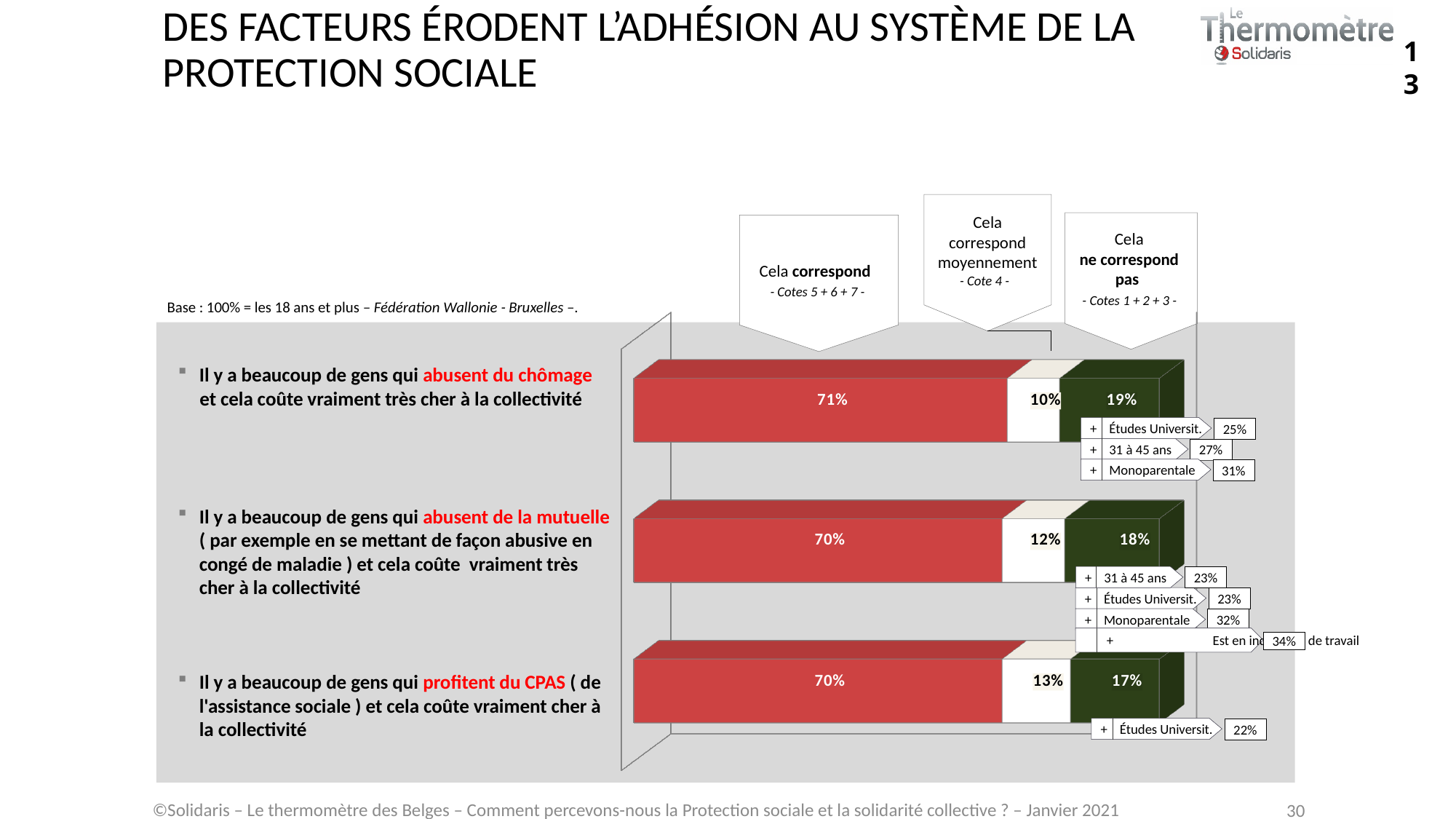
What percentage of respondents say 'Cela correspond moyennement' for the statement about people who 'profitent du CPAS'? 13% How many response categories (series) does each bar contain? 3 Which statement has the lowest 'Cela ne correspond pas' percentage? Il y a beaucoup de gens qui profitent du CPAS What is the total of the three segments for the 'abusent du chômage' bar? 100% Which rating scores (cotes) make up the 'Cela ne correspond pas' category according to the legend? Cotes 1 + 2 + 3 Which statement has the highest 'Cela correspond' percentage? Il y a beaucoup de gens qui abusent du chômage What is the difference between the 'Cela ne correspond pas' percentages for the 'abusent du chômage' statement and the 'profitent du CPAS' statement? 2% What percentage of respondents say 'Cela correspond' for the statement about people who 'abusent du chômage'? 71% What kind of chart is shown on the slide? bar chart Is the 'Cela correspond moyennement' value larger for the 'abusent de la mutuelle' statement or the 'profitent du CPAS' statement? profitent du CPAS How many statements (bars) are plotted in the chart? 3 What percentage of respondents say 'Cela ne correspond pas' for the statement about people who 'abusent de la mutuelle'? 18%